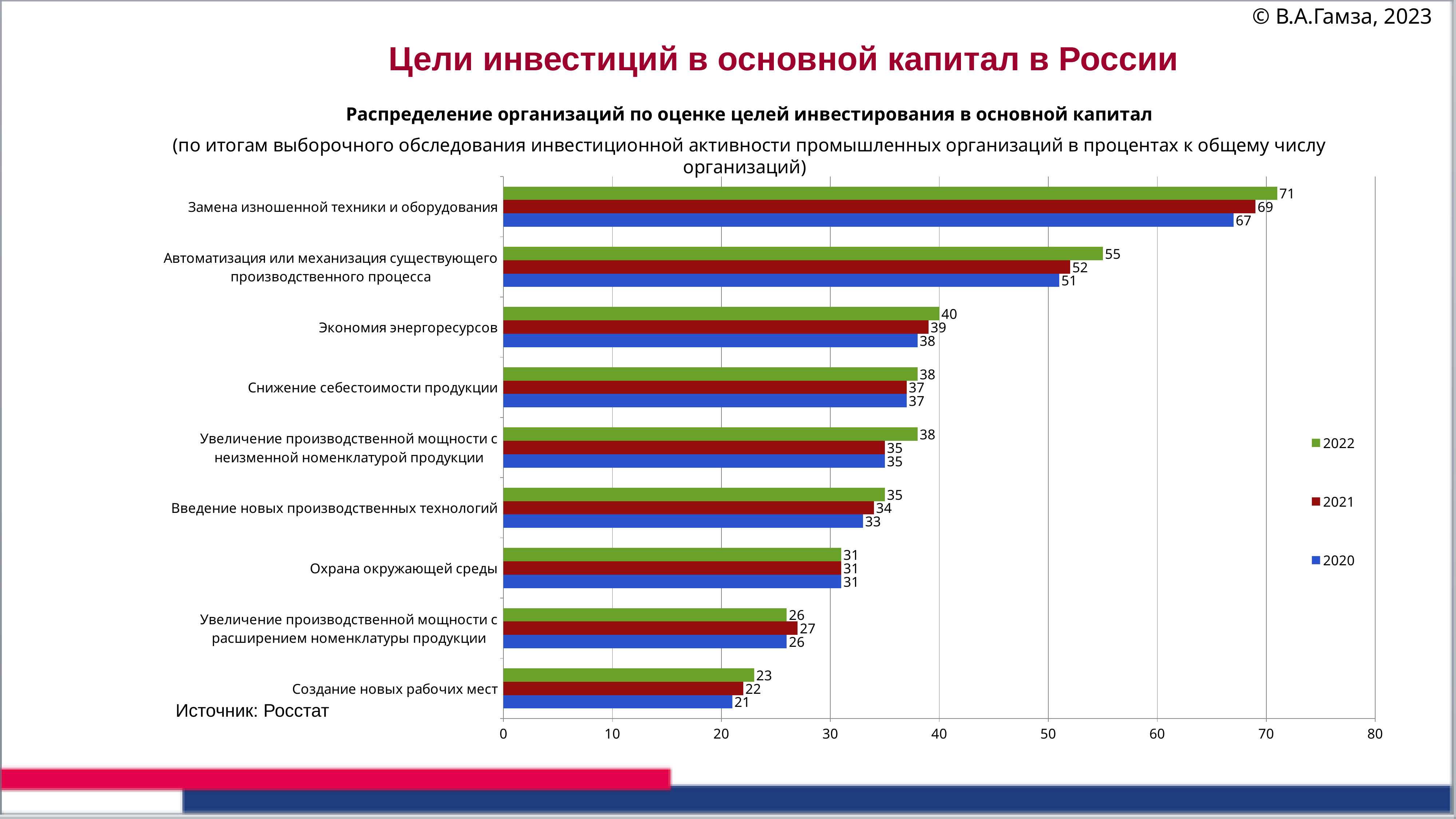
What is the 2020 value for «Автоматизация или механизация существующего производственного процесса»? 51 What is the 2021 value for «Увеличение производственной мощности с расширением номенклатуры продукции»? 27 What is the difference between the 2022 and 2020 values for «Замена изношенной техники и оборудования»? 4 How many series does the legend list? 3 What kind of chart is shown on the slide? Bar chart How many categories are shown on the chart? 9 Which is larger: the 2022 value for «Экономия энергоресурсов» or the 2022 value for «Снижение себестоимости продукции»? Экономия энергоресурсов Which category has the highest 2022 value? Замена изношенной техники и оборудования What is the 2022 value for «Замена изношенной техники и оборудования»? 71 What is the 2021 value for «Экономия энергоресурсов»? 39 Which category has the lowest 2020 value? Создание новых рабочих мест Which colour represents the 2021 series in the legend? Dark red